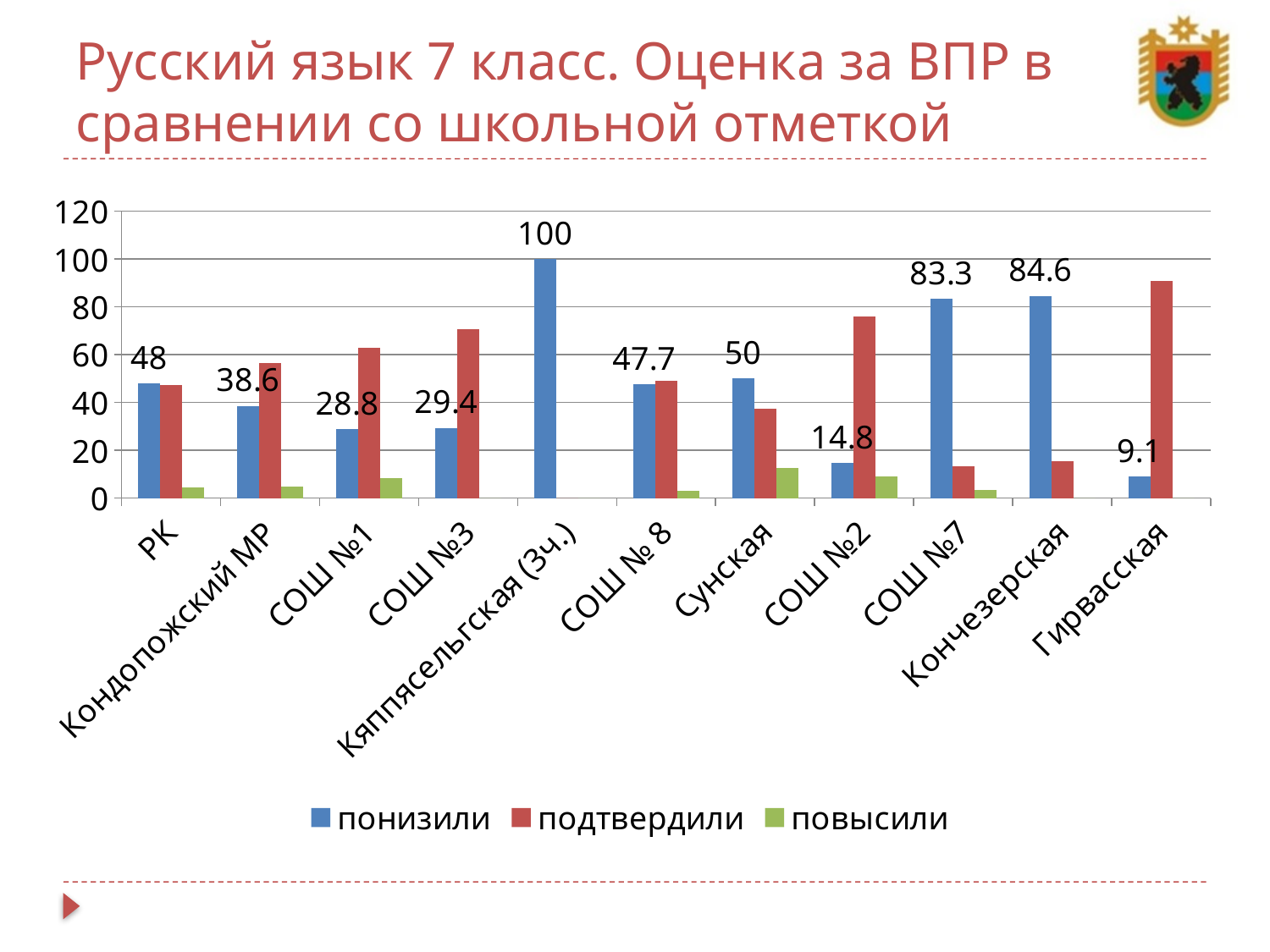
What is the value of понизили for Кяппясельгская (3ч.)? 100 Is the value of подтвердили for СОШ №2 greater or less than 60? greater What kind of chart is shown on the slide? bar chart What is the value of понизили for СОШ №2? 14.8 Is the value of подтвердили for Гирвасская greater or less than 80? greater What is the value of понизили for СОШ №7? 83.3 Which category has the lowest value for понизили? Гирвасская How many series does the legend list? 3 How many categories are shown on the x axis? 11 Which category has the highest value for понизили? Кяппясельгская (3ч.) Which has a larger понизили value, РК or Сунская? Сунская What is the difference between the понизили values for Кончезерская and СОШ №7? 1.3